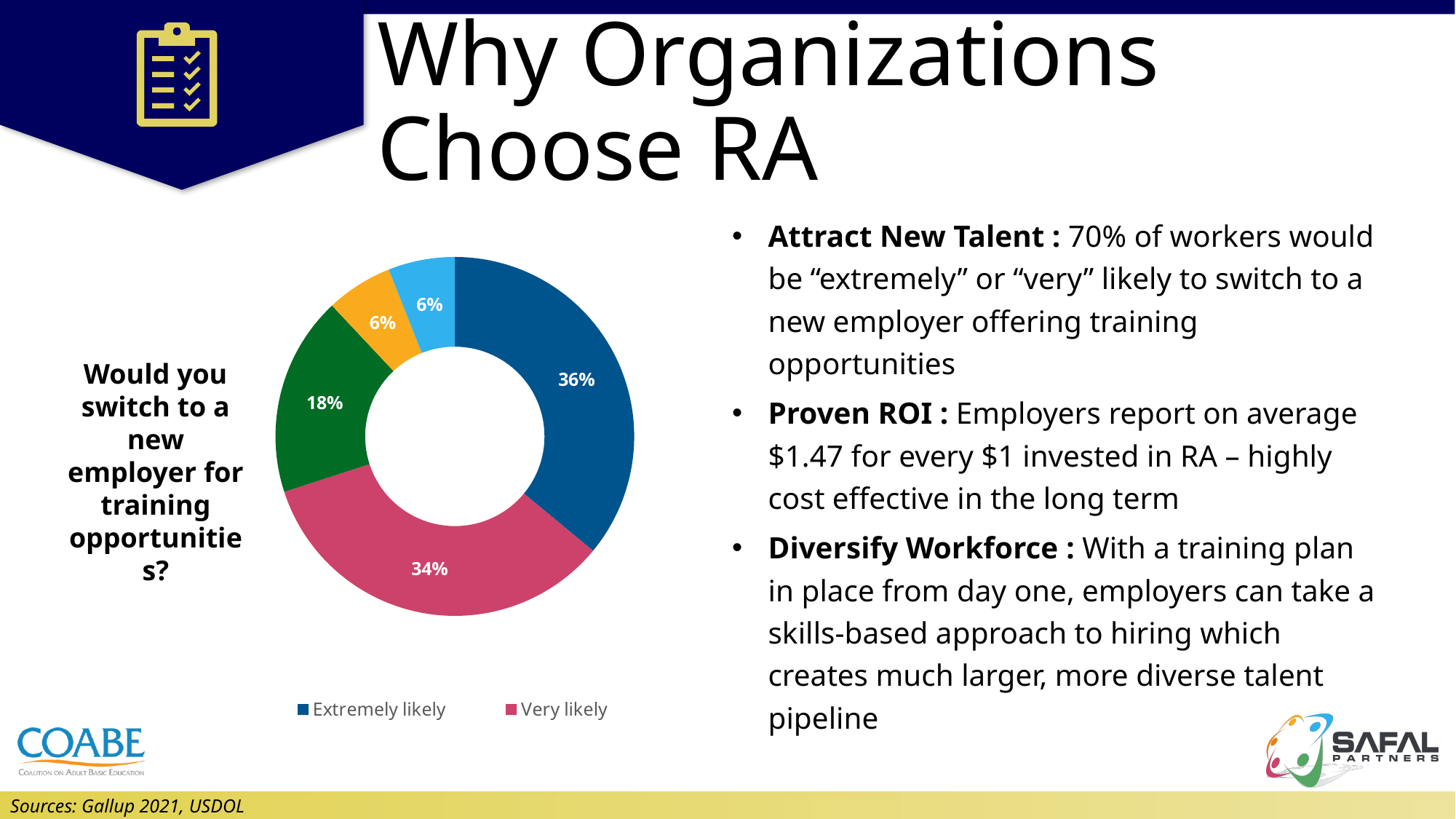
What question is the pie chart answering, according to the text to its left? Would you switch to a new employer for training opportunities? What percentage is shown on the green slice of the pie chart? 18% What is the difference in percentage points between the "Extremely likely" and "Very likely" slices? 2% What kind of chart is shown on the slide? Pie chart (donut) Which slice is larger, "Extremely likely" or "Very likely"? Extremely likely How many slices does the pie chart have? 5 How many entries does the pie chart's legend list? 2 What is the combined percentage of the "Extremely likely" and "Very likely" slices? 70% Which legend category has the largest slice in the pie chart? Extremely likely What percentage of the pie chart is labelled "Very likely"? 34% What percentage of the pie chart is labelled "Extremely likely"? 36% What is the smallest percentage value shown on any slice of the pie chart? 6%